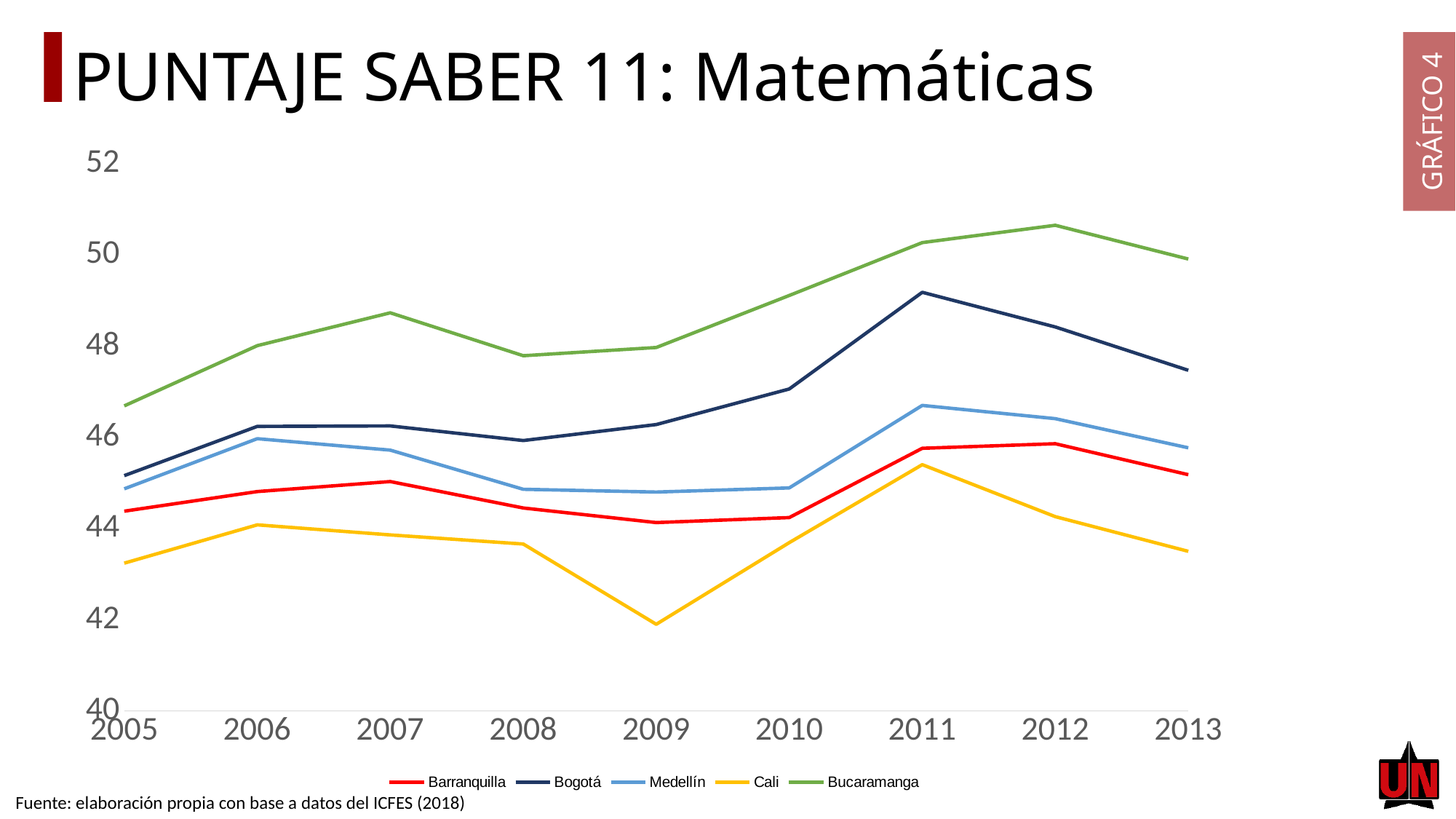
What kind of chart is shown on the slide? line chart Is the value for Bogotá in 2011 greater or less than 48? greater How many series does the legend list? 5 Is the value for Bucaramanga in 2012 greater or less than 50? greater Does the value for Cali rise or fall from 2011 to 2013? fall Which city has the highest score in 2013? Bucaramanga How many years are shown on the x axis? 9 Which city has the lowest score in 2009? Cali What colour is the line for Cali? yellow In 2013, which is larger, the value for Bogotá or the value for Medellín? Bogotá Is the value for Cali in 2009 greater or less than 44? less What is the title of the chart? PUNTAJE SABER 11: Matemáticas